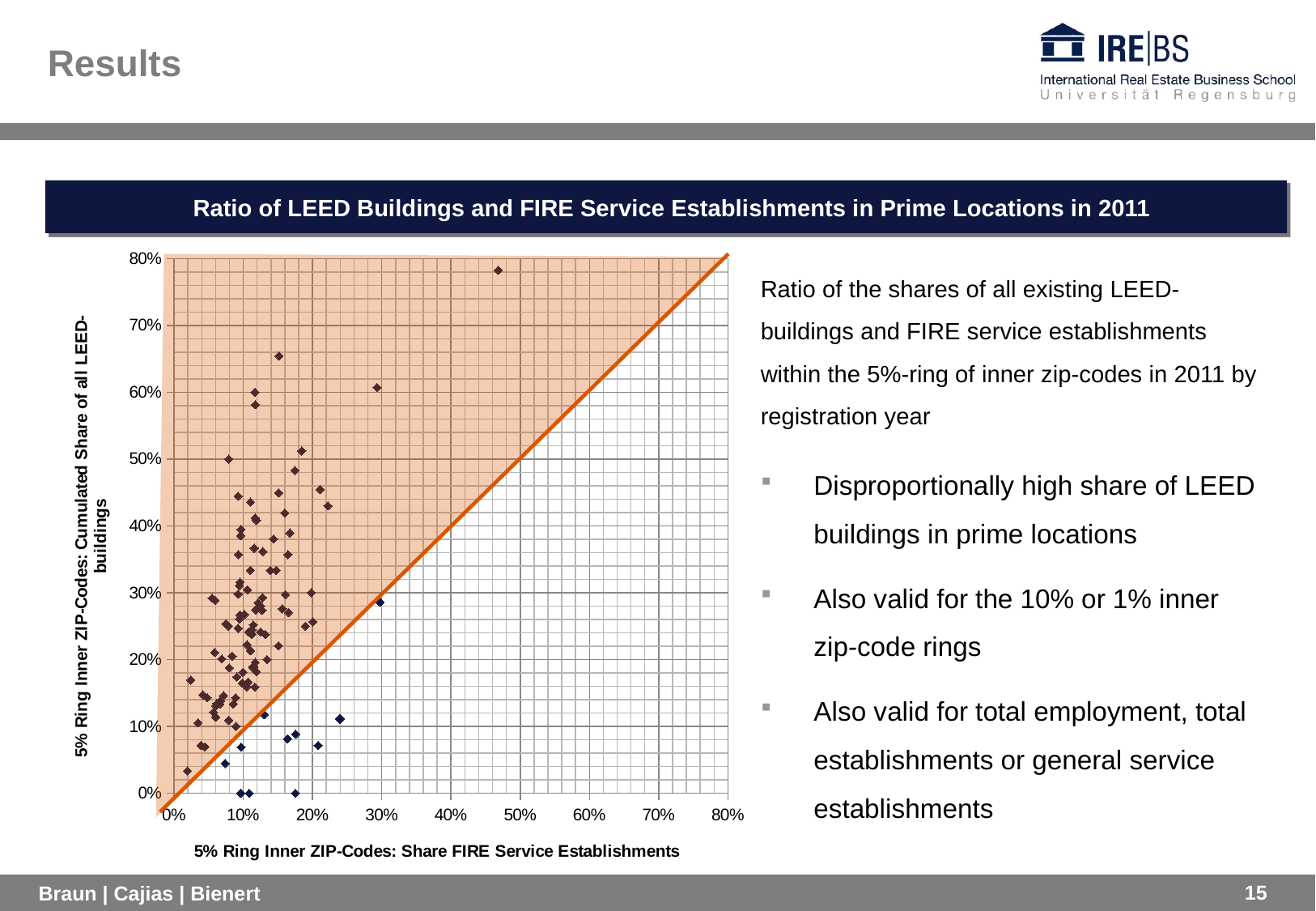
What is the label of the x axis of the chart? 5% Ring Inner ZIP-Codes: Share FIRE Service Establishments What kind of chart is shown on the slide? scatter chart Is the y value of the highest point in the chart greater or less than 70%? greater Is the y value of the point furthest to the right in the chart greater or less than 70%? greater What is the title of the chart? Ratio of LEED Buildings and FIRE Service Establishments in Prime Locations in 2011 Is the x value of the point furthest to the right in the chart greater or less than 40%? greater